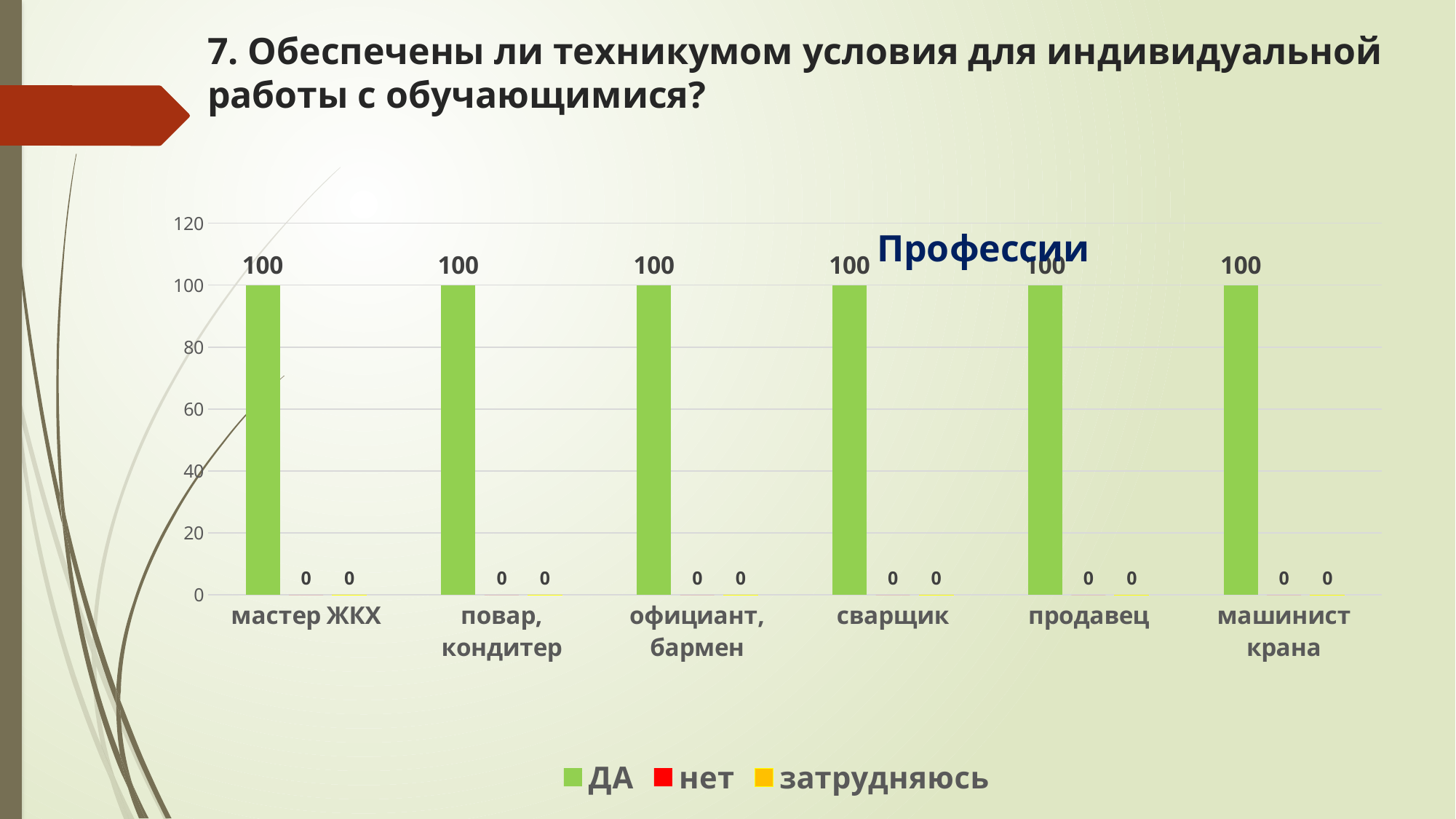
How many series does the legend list? 3 What colour are the ДА bars? green What is the difference between the ДА value and the нет value for повар, кондитер? 100 What is the value of the ДА series for сварщик? 100 How many categories are shown on the x axis? 6 Which is larger for официант, бармен: the ДА value or the затрудняюсь value? ДА What is the title shown on the chart? Профессии What is the value of the затрудняюсь series for мастер ЖКХ? 0 What is the value of the ДА series for машинист крана? 100 What kind of chart is shown on the slide? bar chart What is the value of the нет series for продавец? 0 Is the ДА value for продавец greater or less than 80? greater